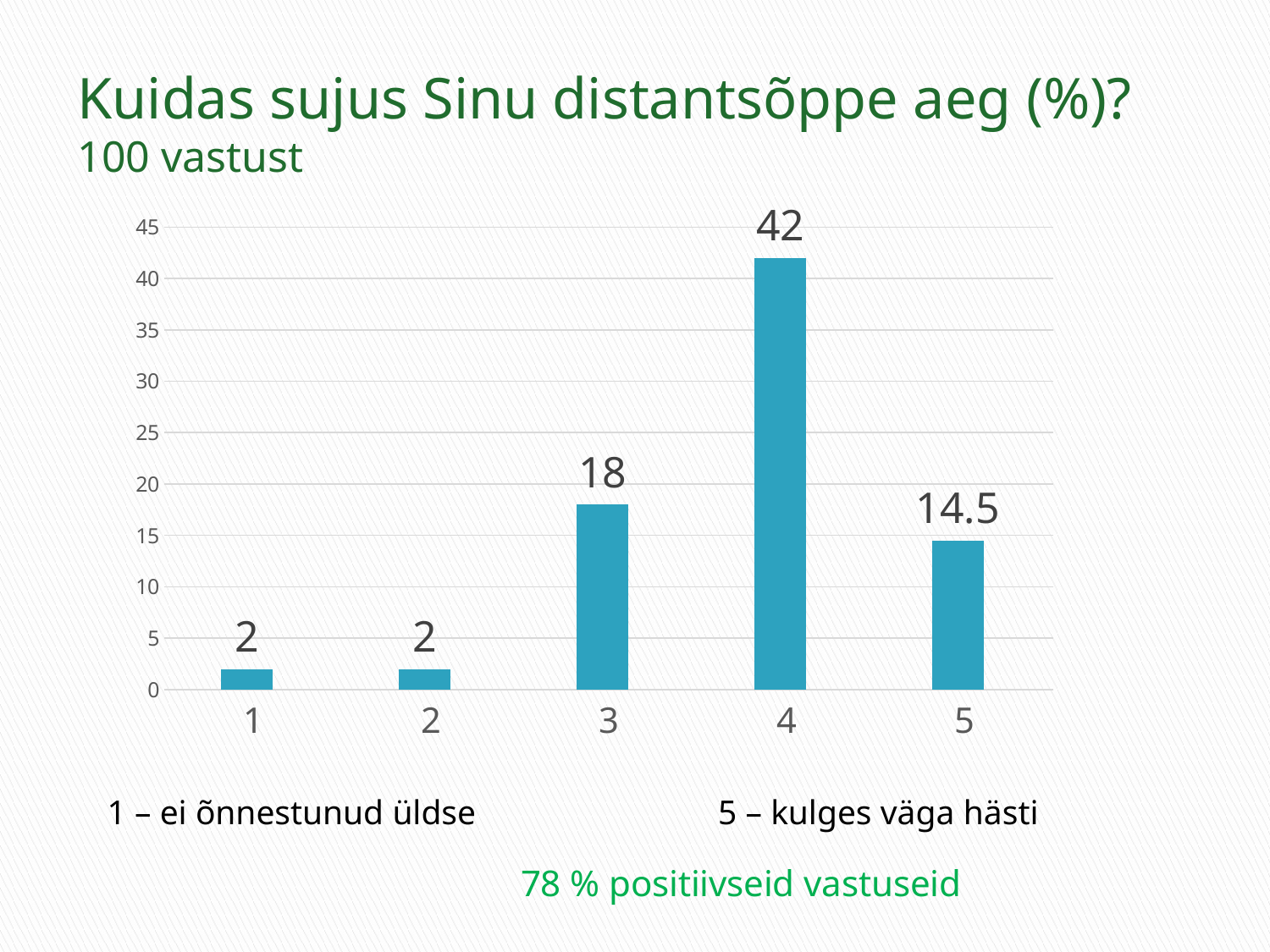
What is the difference between the values for category 3 and category 5? 3.5 What is the title of the chart on the slide? Kuidas sujus Sinu distantsõppe aeg (%)? How many categories are shown on the x axis? 5 What is the value for category 1? 2 Which category has the highest value? 4 What is the value for category 5? 14.5 Is the value for category 4 greater or less than 40? greater What is the value for category 3? 18 What is the difference between the values for category 4 and category 3? 24 Which is larger, the value for category 3 or the value for category 5? 3 What kind of chart is shown on the slide? bar chart What is the value for category 4? 42